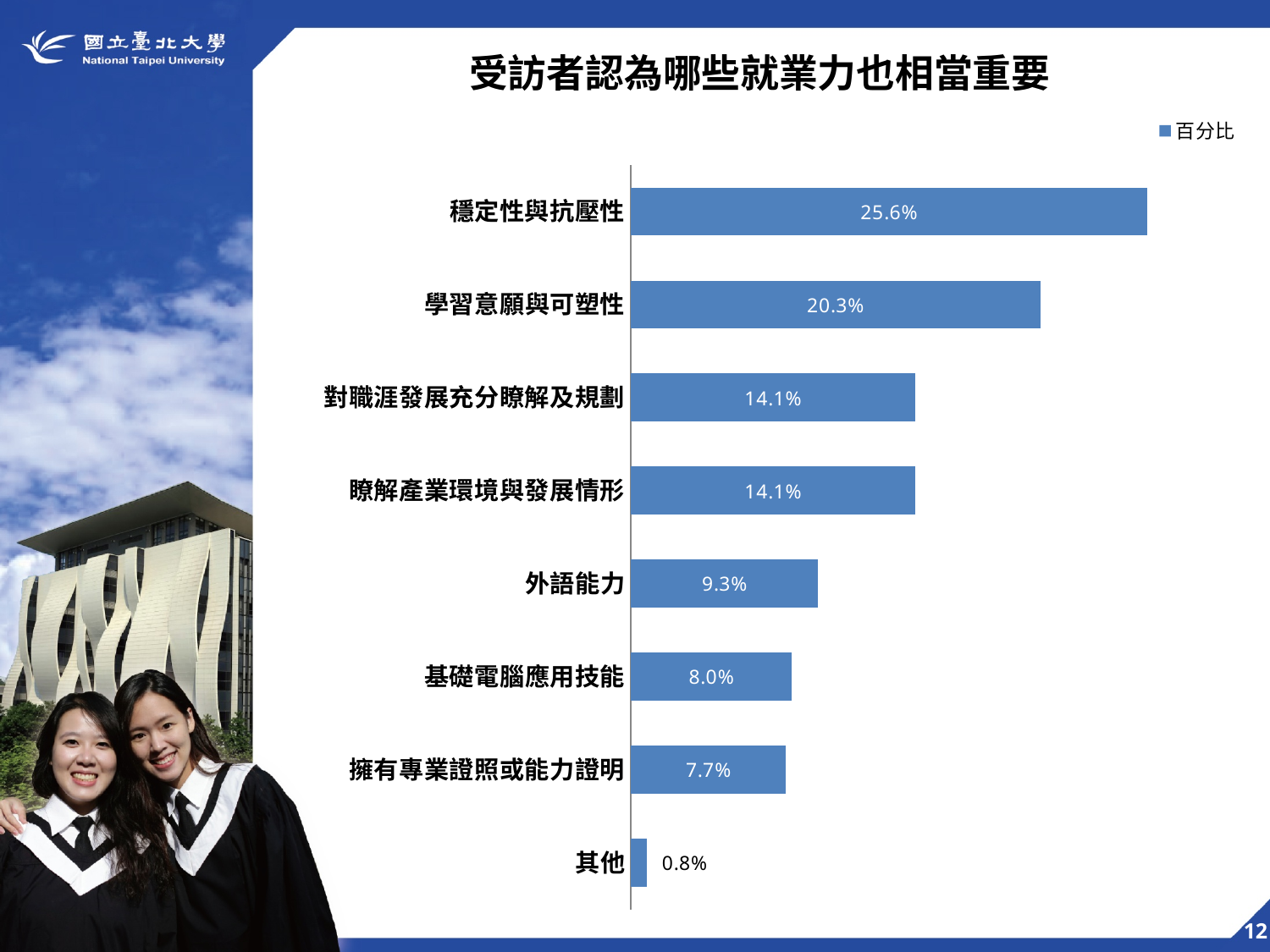
What is the value for 擁有專業證照或能力證明? 7.7% Which category has the highest value? 穩定性與抗壓性 What is the value for 外語能力? 9.3% What is the title of the chart? 受訪者認為哪些就業力也相當重要 How many categories are shown in the chart? 8 What is the difference between 穩定性與抗壓性 and 學習意願與可塑性? 5.3% How many series does the legend list? 1 What is the value for 穩定性與抗壓性? 25.6% What is the value for 學習意願與可塑性? 20.3% Which category has the lowest value? 其他 Which is larger, 基礎電腦應用技能 or 擁有專業證照或能力證明? 基礎電腦應用技能 What kind of chart is shown? Bar chart